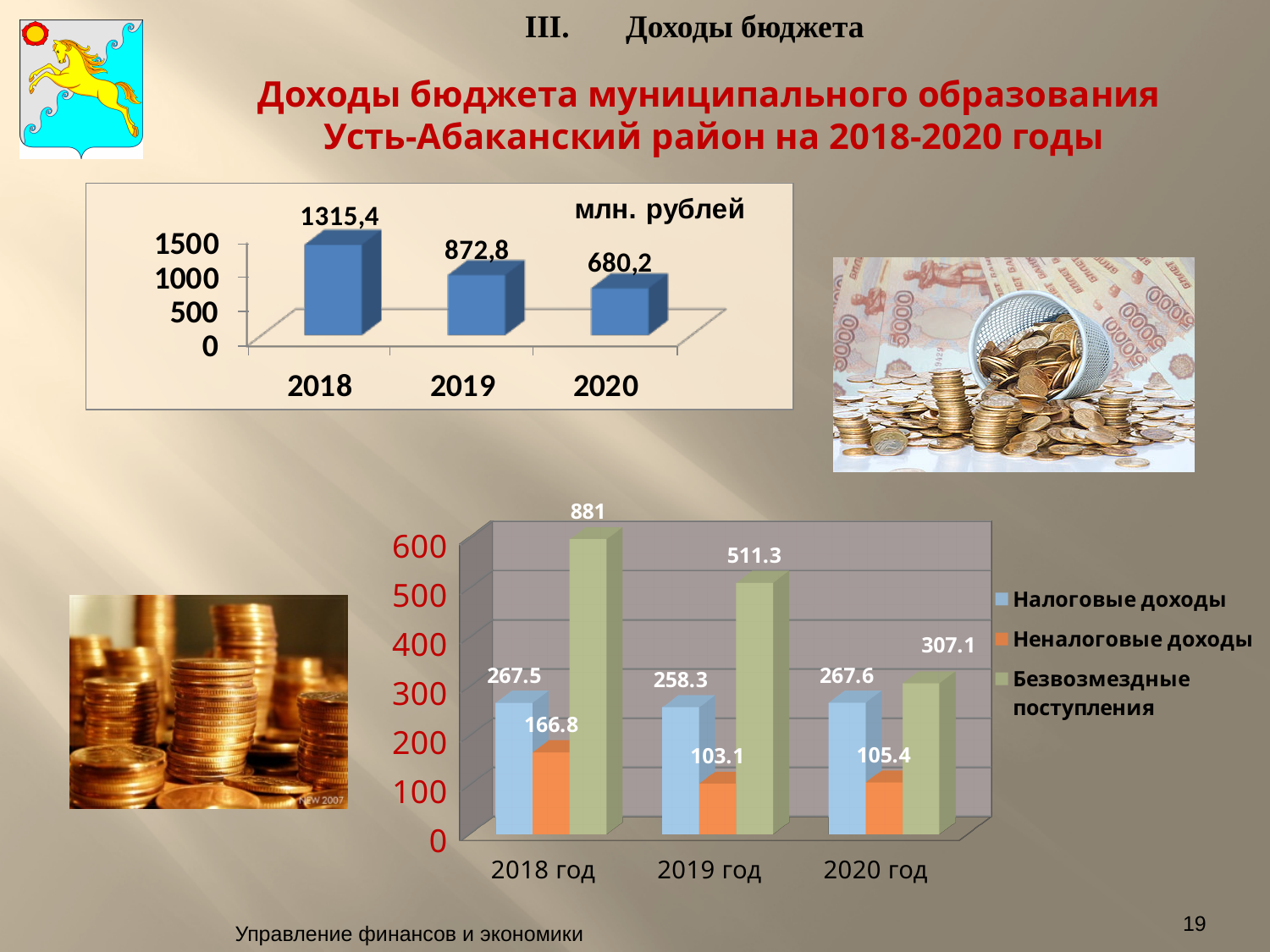
In the top chart, what is the value for 2020? 680,2 In the bottom chart, what is the value of Налоговые доходы for 2020 год? 267.6 In the top chart, what is the value for 2018? 1315,4 In the bottom chart, what is the value of Неналоговые доходы for 2019 год? 103.1 In the bottom chart, which is larger for 2020 год: Налоговые доходы or Неналоговые доходы? Налоговые доходы In the top chart, do the values rise or fall from 2018 to 2020? fall In the bottom chart, what is the difference between Безвозмездные поступления in 2018 год and 2019 год? 369.7 What kind of chart is the bottom chart? bar chart In the bottom chart, how many series does the legend list? 3 In the bottom chart, what is the value of Безвозмездные поступления for 2018 год? 881 In the top chart, which year has the lowest value? 2020 In the top chart, what unit is shown for the values? млн. рублей